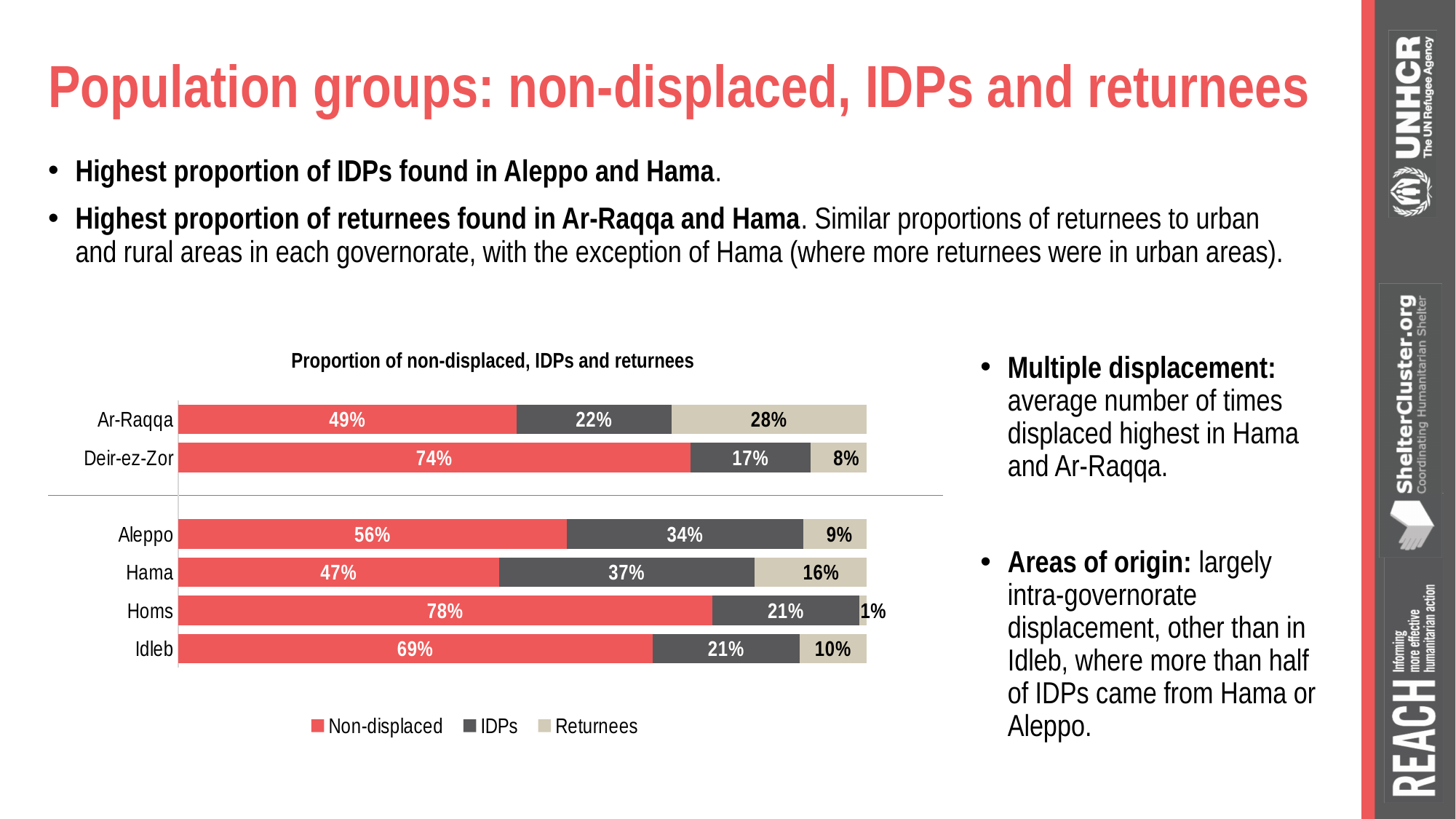
Which governorate has the lowest Returnees proportion? Homs How many governorates are shown in the chart? 6 What is the Returnees value for Homs? 1% Which is larger, the Returnees value for Hama or for Idleb? Hama How many series does the legend list? 3 Which governorate has the highest Non-displaced proportion? Homs What is the IDPs value for Hama? 37% What is the difference between the Non-displaced values for Deir-ez-Zor and Ar-Raqqa? 25% What type of chart is shown on the slide? Stacked bar chart What is the Returnees value for Ar-Raqqa? 28% Which governorate has the highest IDPs proportion? Hama What is the Non-displaced value for Homs? 78%